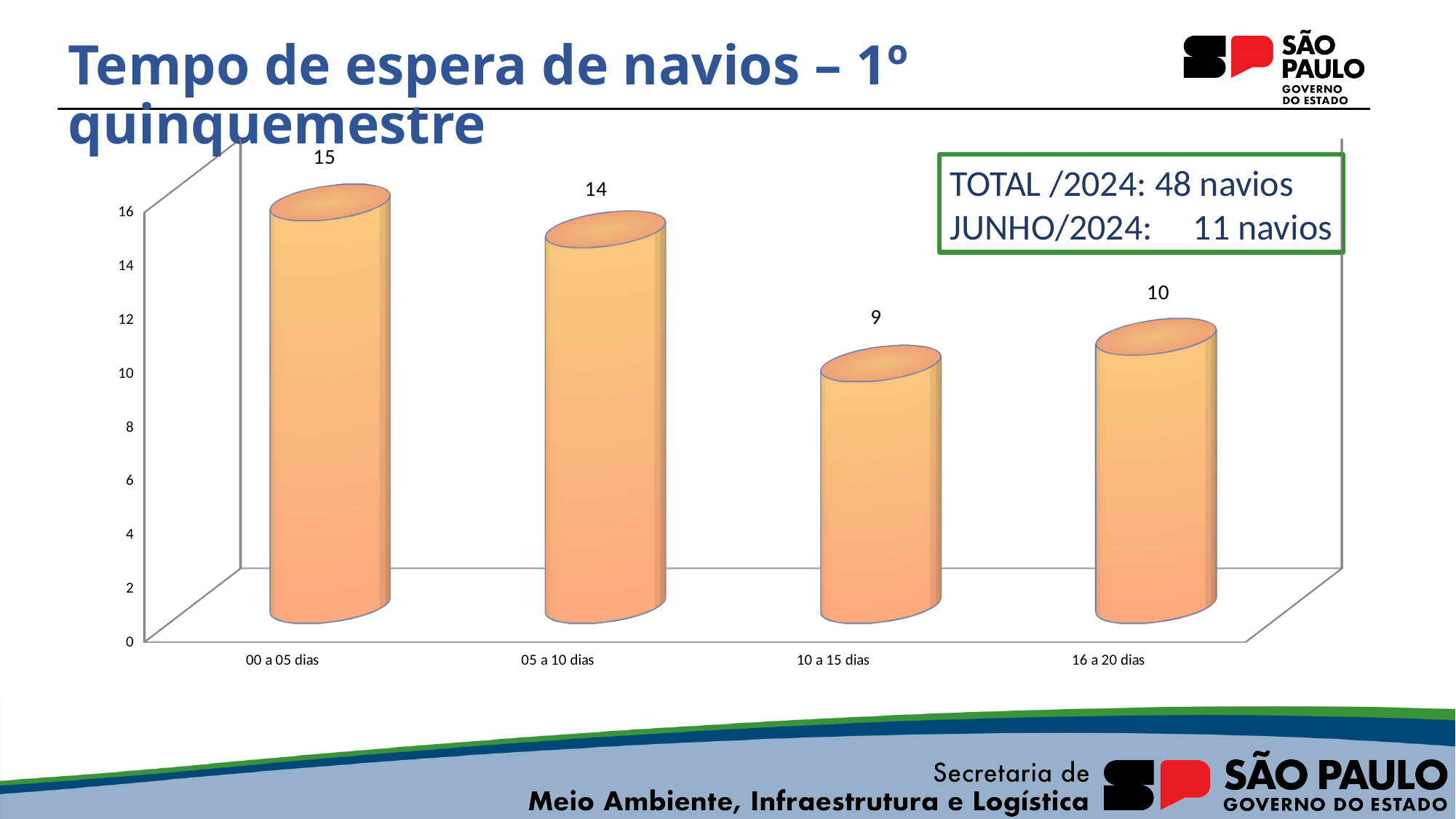
What is the value for the "00 a 05 dias" category? 15 How many categories are shown on the x axis? 4 Which category has the highest value? 00 a 05 dias According to the text box on the slide, how many ships (navios) are reported for JUNHO/2024? 11 navios What is the difference between the values for "00 a 05 dias" and "10 a 15 dias"? 6 What is the total of the four plotted values? 48 What kind of chart is shown on the slide? Bar chart Which category has the lowest value? 10 a 15 dias What is the value for the "05 a 10 dias" category? 14 Which is larger, the value for "05 a 10 dias" or the value for "16 a 20 dias"? 05 a 10 dias What is the value for the "10 a 15 dias" category? 9 What is the value for the "16 a 20 dias" category? 10